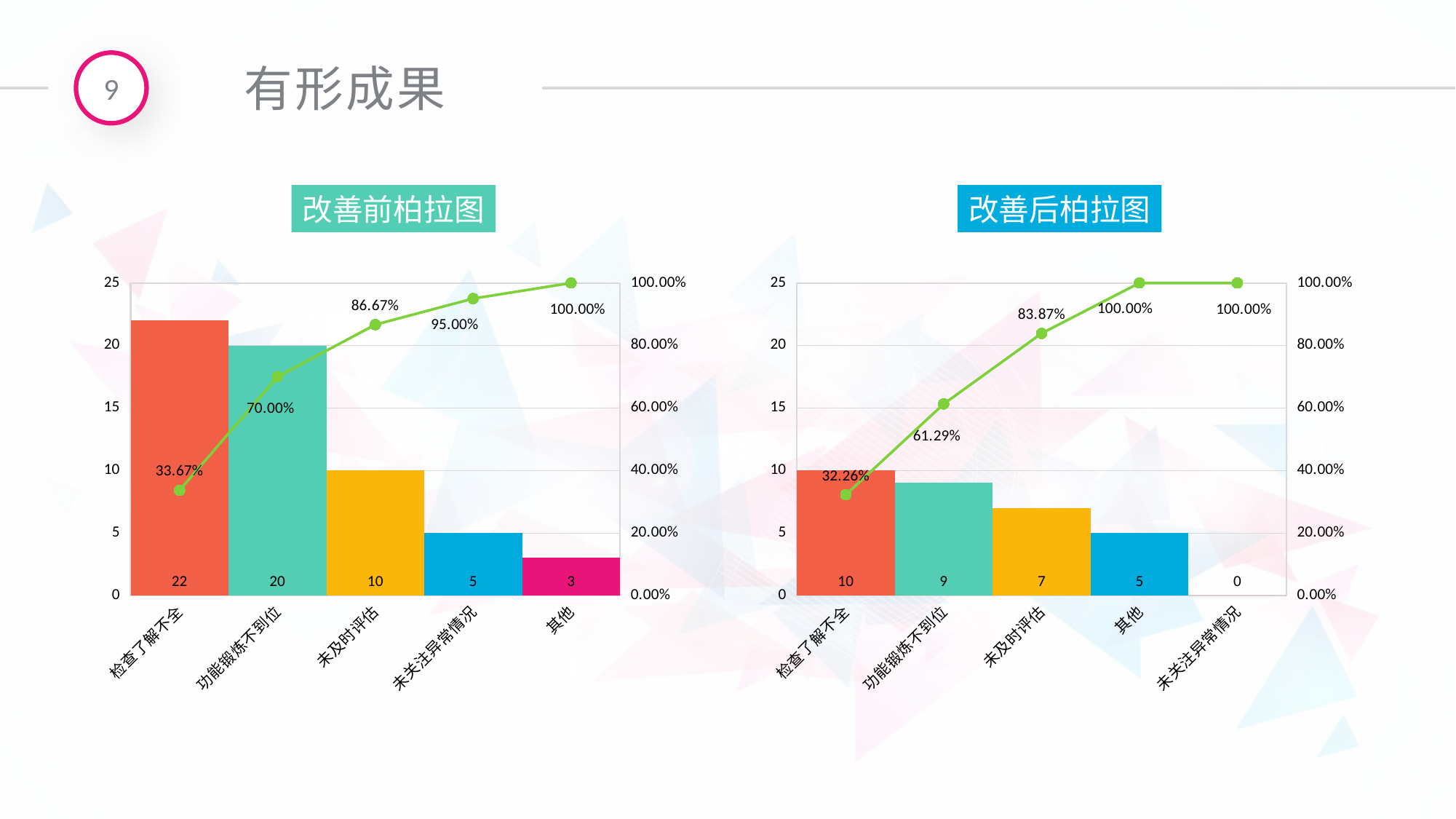
In the 改善后柏拉图 chart, which category has the highest bar? 检查了解不全 In the 改善前柏拉图 chart, how many categories are shown on the x axis? 5 Which is larger: the bar for 检查了解不全 in the 改善前柏拉图 chart or the bar for 检查了解不全 in the 改善后柏拉图 chart? 改善前柏拉图 In the 改善前柏拉图 chart, what is the difference between the bars for 检查了解不全 and 未及时评估? 12 In the 改善后柏拉图 chart, does the cumulative percentage line rise or fall from left to right? rise In the 改善后柏拉图 chart, what cumulative percentage is shown at 检查了解不全? 32.26% In the 改善前柏拉图 chart, what is the value of the bar for 检查了解不全? 22 In the 改善前柏拉图 chart, which category has the lowest bar? 其他 In the 改善前柏拉图 chart, what cumulative percentage is shown at 功能锻炼不到位? 70.00% What kind of chart is the 改善前柏拉图 chart? Combined bar and line chart (Pareto chart) In the 改善后柏拉图 chart, what is the value of the bar for 未及时评估? 7 In the 改善后柏拉图 chart, what is the value of the bar for 未关注异常情况? 0